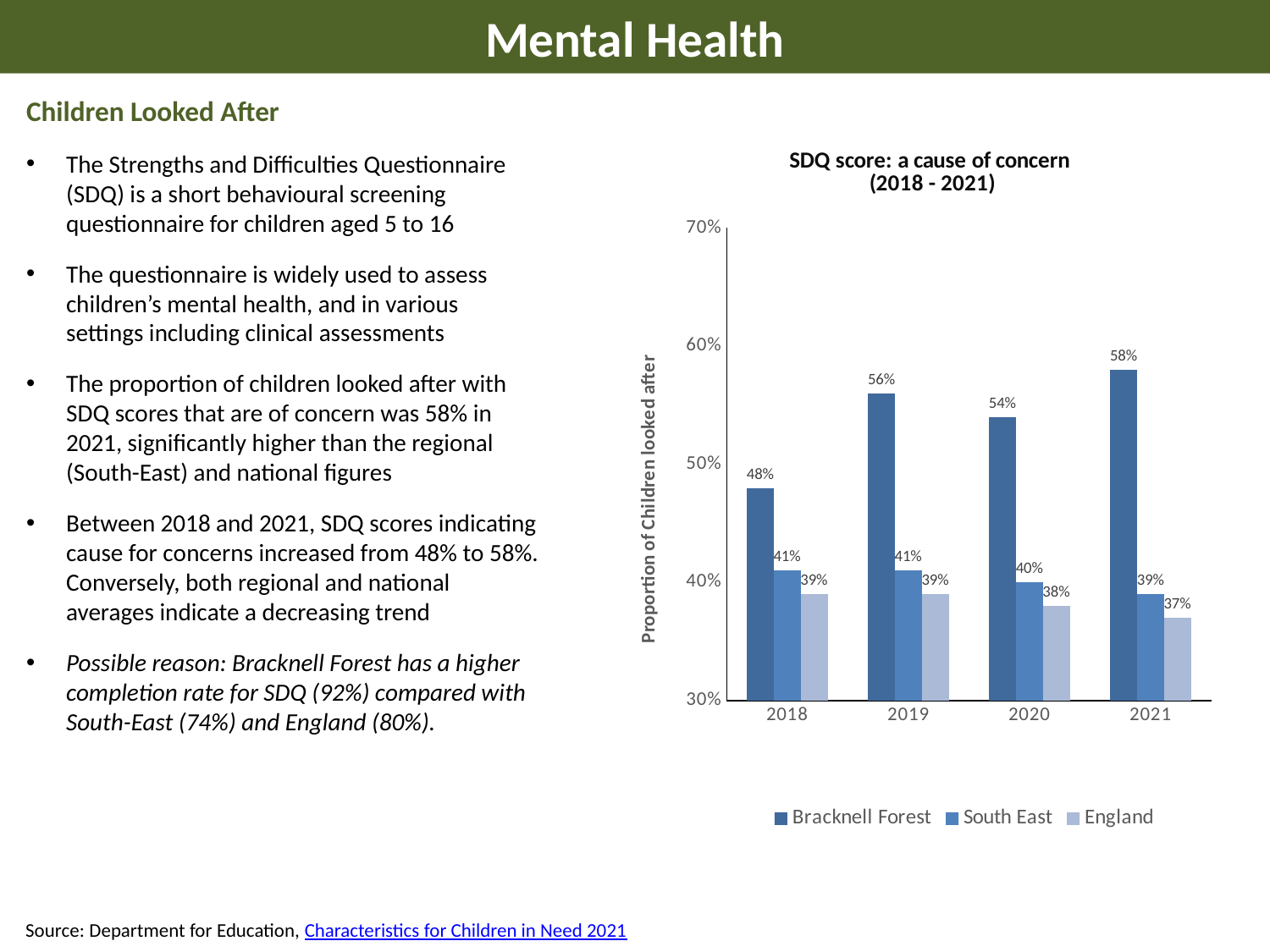
What is the value for Bracknell Forest in 2021? 58% Which is larger in 2019: the Bracknell Forest value or the South East value? Bracknell Forest Does the England value rise or fall from 2018 to 2021? Fall How many series does the legend list? 3 What kind of chart is shown? Bar chart How many years are shown on the x axis? 4 Is the value for Bracknell Forest in 2020 greater or less than 50%? greater What is the value for England in 2020? 38% What is the value for South East in 2018? 41% In which year is the Bracknell Forest value lowest? 2018 What is the difference between the Bracknell Forest and England values in 2021? 21% In which year is the Bracknell Forest value highest? 2021